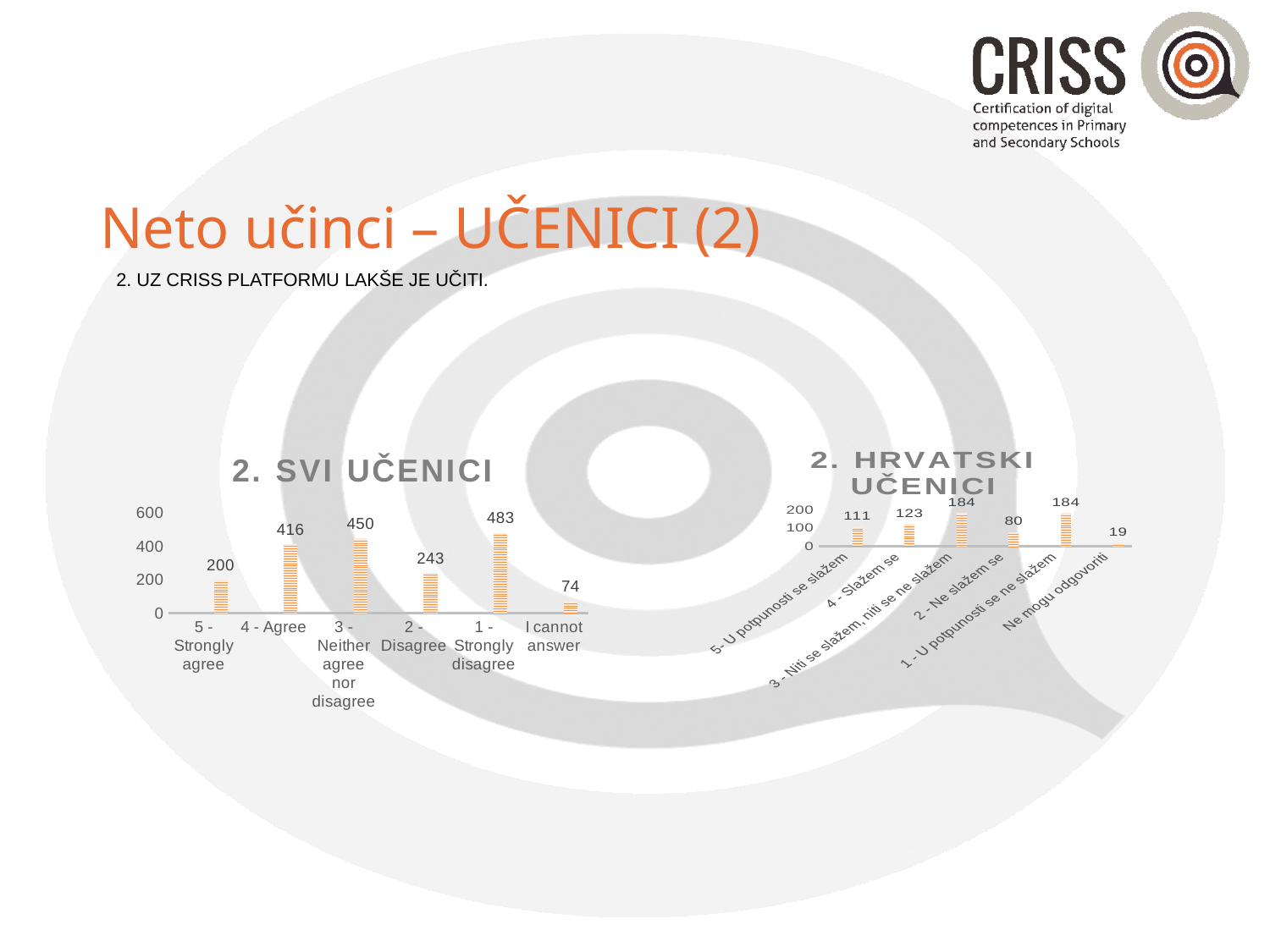
In the chart titled "2. SVI UČENICI", what is the value for "I cannot answer"? 74 In the chart titled "2. SVI UČENICI", what is the difference between the values for "3 - Neither agree nor disagree" and "2 - Disagree"? 207 In the chart titled "2. HRVATSKI UČENICI", what is the value for "4 - Slažem se"? 123 In the chart titled "2. HRVATSKI UČENICI", which category has the lowest value? Ne mogu odgovoriti In the chart titled "2. HRVATSKI UČENICI", what is the difference between the values for "5 - U potpunosti se slažem" and "Ne mogu odgovoriti"? 92 In the chart titled "2. SVI UČENICI", which is larger: the value for "5 - Strongly agree" or the value for "2 - Disagree"? 2 - Disagree In the chart titled "2. HRVATSKI UČENICI", what is the value for "2 - Ne slažem se"? 80 What kind of chart is the chart titled "2. HRVATSKI UČENICI"? Bar chart In the chart titled "2. SVI UČENICI", what is the value for "4 - Agree"? 416 In the chart titled "2. SVI UČENICI", how many categories are shown on the x axis? 6 In the chart titled "2. SVI UČENICI", which category has the highest value? 1 - Strongly disagree In the chart titled "2. SVI UČENICI", which category has the lowest value? I cannot answer